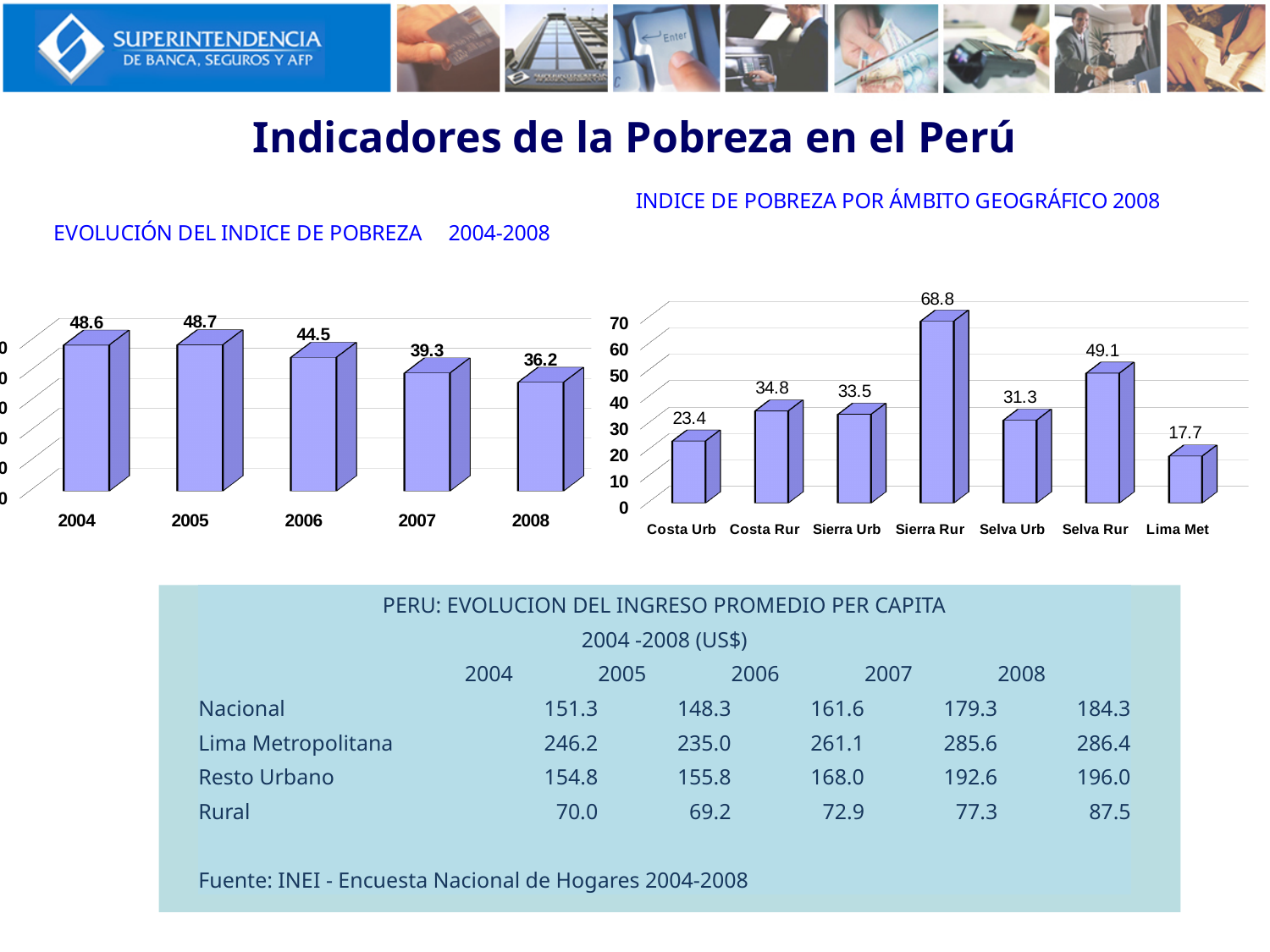
What kind of chart is the one titled INDICE DE POBREZA POR ÁMBITO GEOGRÁFICO 2008? bar chart In the chart titled INDICE DE POBREZA POR ÁMBITO GEOGRÁFICO 2008, how many categories are shown? 7 In the chart titled INDICE DE POBREZA POR ÁMBITO GEOGRÁFICO 2008, what is the value for Selva Rur? 49.1 In the chart titled EVOLUCIÓN DEL INDICE DE POBREZA 2004-2008, what is the difference between the 2004 value and the 2008 value? 12.4 In the chart titled EVOLUCIÓN DEL INDICE DE POBREZA 2004-2008, how many years are shown? 5 In the chart titled INDICE DE POBREZA POR ÁMBITO GEOGRÁFICO 2008, which category has the highest value? Sierra Rur In the chart titled EVOLUCIÓN DEL INDICE DE POBREZA 2004-2008, what is the value for 2006? 44.5 In the chart titled INDICE DE POBREZA POR ÁMBITO GEOGRÁFICO 2008, what is the difference between Sierra Rur and Costa Urb? 45.4 In the chart titled EVOLUCIÓN DEL INDICE DE POBREZA 2004-2008, which year has the lowest value? 2008 In the chart titled EVOLUCIÓN DEL INDICE DE POBREZA 2004-2008, do the values generally rise or fall from 2005 to 2008? fall In the chart titled INDICE DE POBREZA POR ÁMBITO GEOGRÁFICO 2008, which category has the lowest value? Lima Met In the chart titled INDICE DE POBREZA POR ÁMBITO GEOGRÁFICO 2008, which is larger, Costa Rur or Selva Urb? Costa Rur